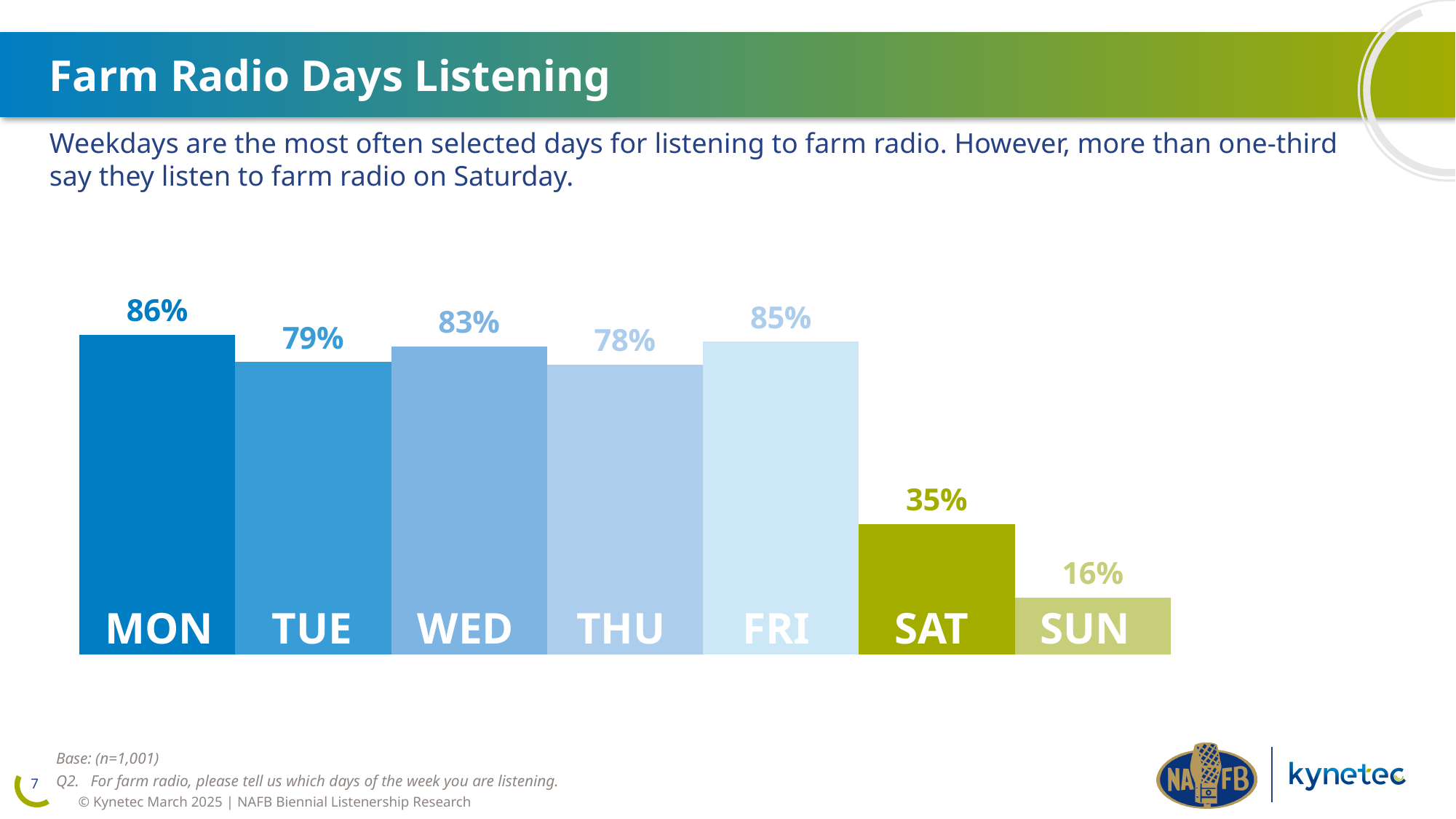
Which day has a higher value, Wednesday or Tuesday? WED What is the difference between the Friday and Saturday values? 50% What is the value shown for Thursday? 78% Which day has the lowest percentage of farm radio listening? SUN Which day has the highest percentage of farm radio listening? MON What is the difference between the Monday and Sunday values? 70% Which day has a higher value, Saturday or Sunday? SAT What kind of chart is shown on the slide? Bar chart What is the value shown for Saturday? 35% How many days of the week are shown in the chart? 7 What is the title of the slide? Farm Radio Days Listening What percentage of respondents listen to farm radio on Monday? 86%